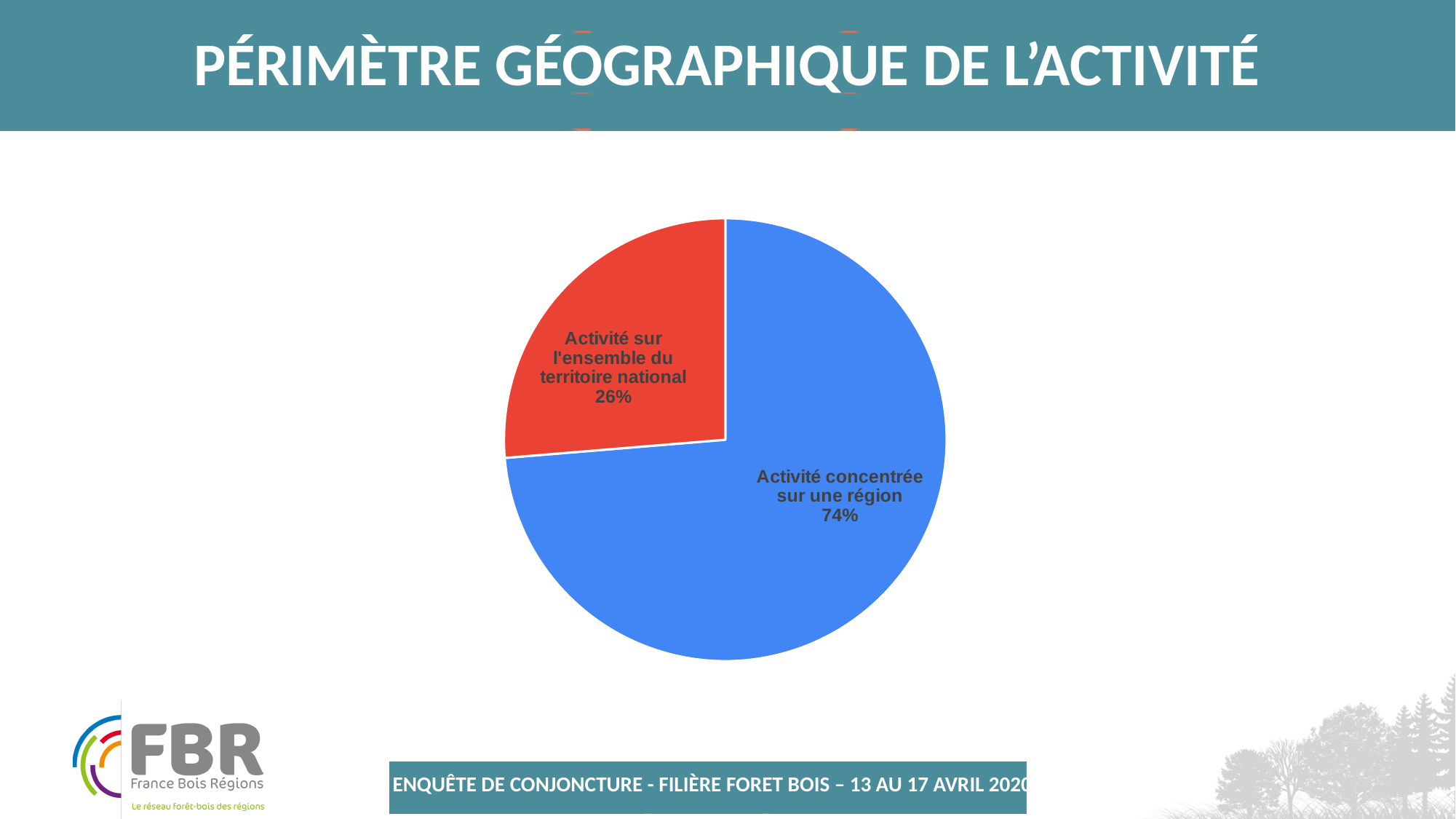
Which is larger: "Activité concentrée sur une région" or "Activité sur l'ensemble du territoire national"? Activité concentrée sur une région What percentage is shown for "Activité sur l'ensemble du territoire national"? 26% What is the title of the slide containing the pie chart? PÉRIMÈTRE GÉOGRAPHIQUE DE L'ACTIVITÉ What share of the pie does "Activité sur l'ensemble du territoire national" represent? 26% What colour is the slice for "Activité concentrée sur une région"? Blue Which slice of the pie chart is the smallest? Activité sur l'ensemble du territoire national How many slices does the pie chart have? 2 Which slice of the pie chart is the largest? Activité concentrée sur une région What type of chart is shown on the slide? Pie chart What is the difference in percentage points between "Activité concentrée sur une région" and "Activité sur l'ensemble du territoire national"? 48 What percentage is shown for "Activité concentrée sur une région"? 74%